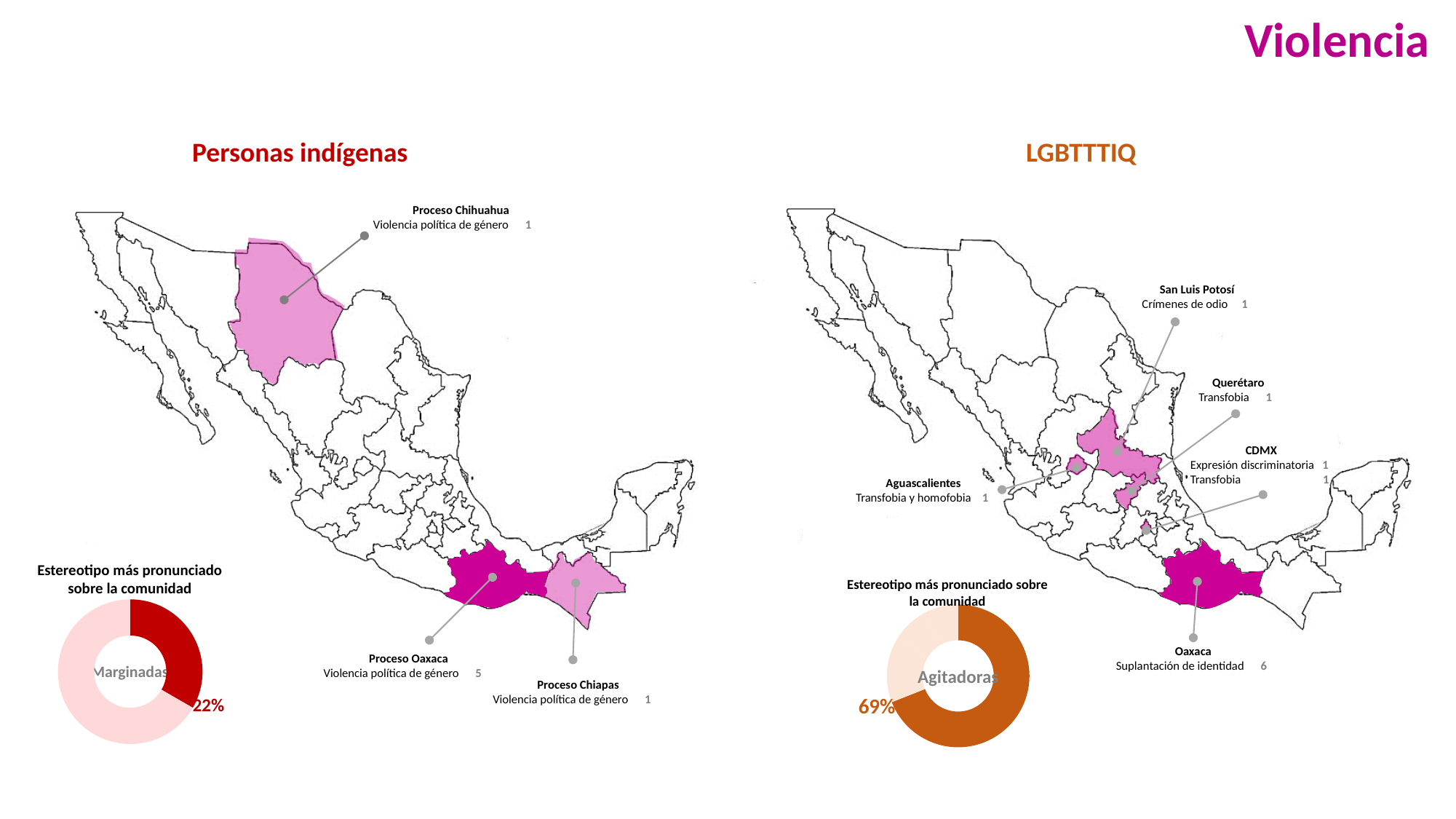
In the donut chart under 'Personas indígenas', what percentage is shown for the stereotype 'Marginadas'? 22% What is the title of the donut chart on the left side of the slide? Estereotipo más pronunciado sobre la comunidad In the 'LGBTTTIQ' map, how many states are annotated with cases? 5 What is the difference between the 'Agitadoras' share (69%) and the 'Marginadas' share (22%)? 47 percentage points Which donut chart shows the larger highlighted share: the 'Personas indígenas' one (Marginadas) or the 'LGBTTTIQ' one (Agitadoras)? LGBTTTIQ (Agitadoras) In the 'Personas indígenas' map, how many cases of 'Violencia política de género' are listed for Proceso Oaxaca? 5 In the 'Personas indígenas' map, which state has the highest number of cases? Oaxaca In the 'LGBTTTIQ' map, what type of violence is listed for San Luis Potosí? Crímenes de odio In the donut chart under 'LGBTTTIQ', what percentage is shown for the stereotype 'Agitadoras'? 69% What kind of chart is used to show the most pronounced stereotype for each community? Donut (pie) chart In the 'Personas indígenas' map, how many cases are listed for Proceso Chihuahua? 1 In the 'LGBTTTIQ' map, how many cases of 'Suplantación de identidad' are listed for Oaxaca? 6